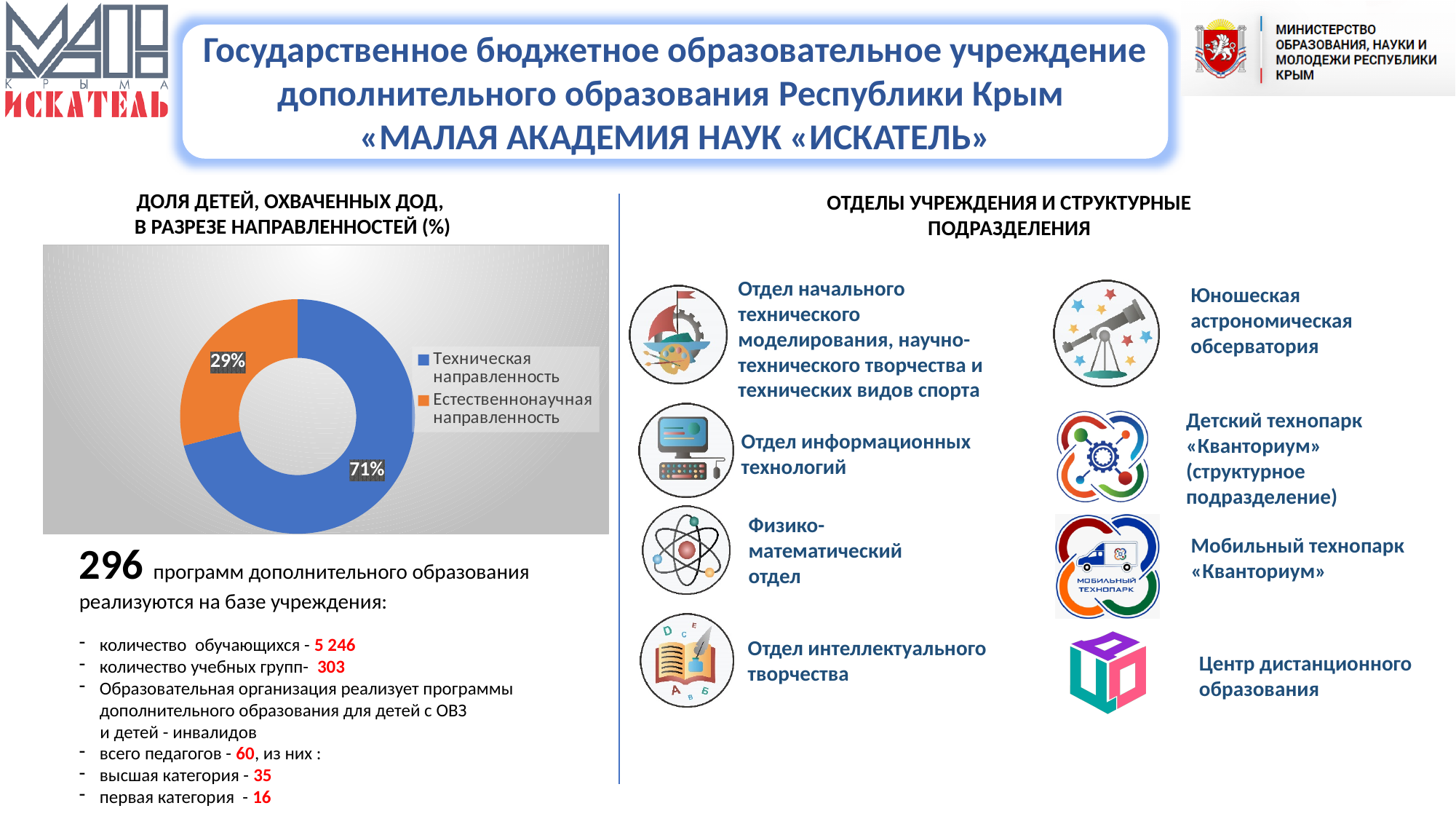
What share of the pie chart is labelled for "Техническая направленность"? 71% What type of chart is shown under the title "ДОЛЯ ДЕТЕЙ, ОХВАЧЕННЫХ ДОД, В РАЗРЕЗЕ НАПРАВЛЕННОСТЕЙ (%)"? Pie (doughnut) chart What is the total of the two percentages shown in the pie chart? 100% By how many percentage points does "Техническая направленность" exceed "Естественнонаучная направленность" in the pie chart? 42 Which category has the smallest slice in the pie chart? Естественнонаучная направленность How many slices does the pie chart have? 2 What share of the pie chart is labelled for "Естественнонаучная направленность"? 29% Which is larger in the pie chart: "Техническая направленность" or "Естественнонаучная направленность"? Техническая направленность How many entries does the legend of the pie chart list? 2 Which category has the largest slice in the pie chart? Техническая направленность What colour is the slice for "Техническая направленность" in the pie chart? Blue What colour is the slice for "Естественнонаучная направленность" in the pie chart? Orange